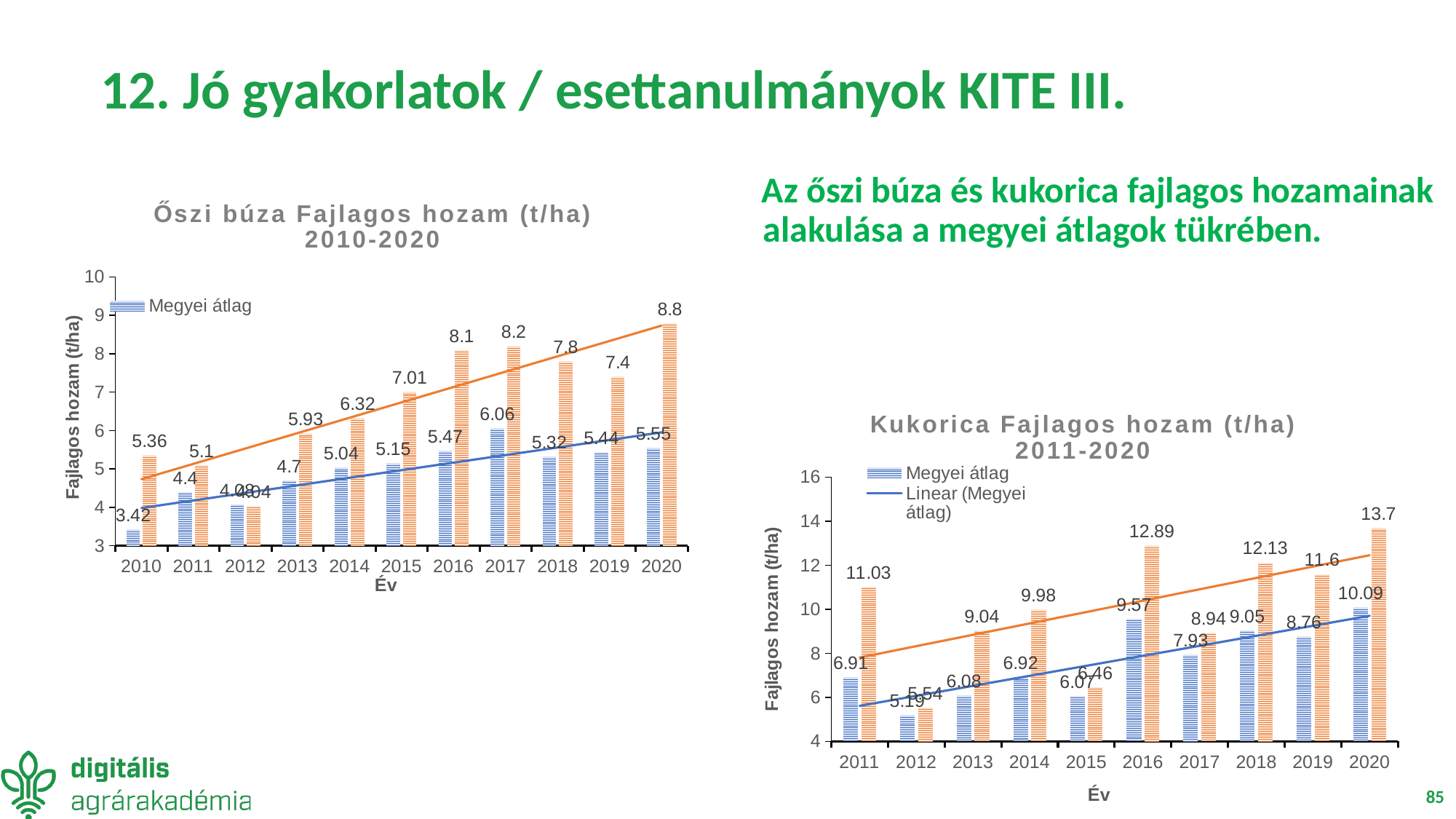
In the chart titled "Kukorica Fajlagos hozam (t/ha) 2011-2020", how many entries does the legend list? 2 In the chart titled "Őszi búza Fajlagos hozam (t/ha) 2010-2020", what is the value of the orange bar for 2020? 8.8 In the chart titled "Őszi búza Fajlagos hozam (t/ha) 2010-2020", which year has the highest Megyei átlag value? 2017 In the chart titled "Őszi búza Fajlagos hozam (t/ha) 2010-2020", how many years are shown on the x axis? 11 In the chart titled "Őszi búza Fajlagos hozam (t/ha) 2010-2020", what is the difference between the orange bar and the Megyei átlag bar for 2017? 2.14 In the chart titled "Kukorica Fajlagos hozam (t/ha) 2011-2020", which year has the highest orange bar? 2020 In the chart titled "Őszi búza Fajlagos hozam (t/ha) 2010-2020", what is the Megyei átlag value for 2010? 3.42 In the chart titled "Kukorica Fajlagos hozam (t/ha) 2011-2020", what is the difference between the orange bar and the Megyei átlag bar for 2011? 4.12 In the chart titled "Kukorica Fajlagos hozam (t/ha) 2011-2020", which year has the lowest Megyei átlag value? 2012 In the chart titled "Őszi búza Fajlagos hozam (t/ha) 2010-2020", what kind of chart is used for the data? Bar chart In the chart titled "Kukorica Fajlagos hozam (t/ha) 2011-2020", is the Megyei átlag value for 2019 larger or smaller than the value for 2018? Smaller In the chart titled "Kukorica Fajlagos hozam (t/ha) 2011-2020", what is the Megyei átlag value for 2016? 9.57